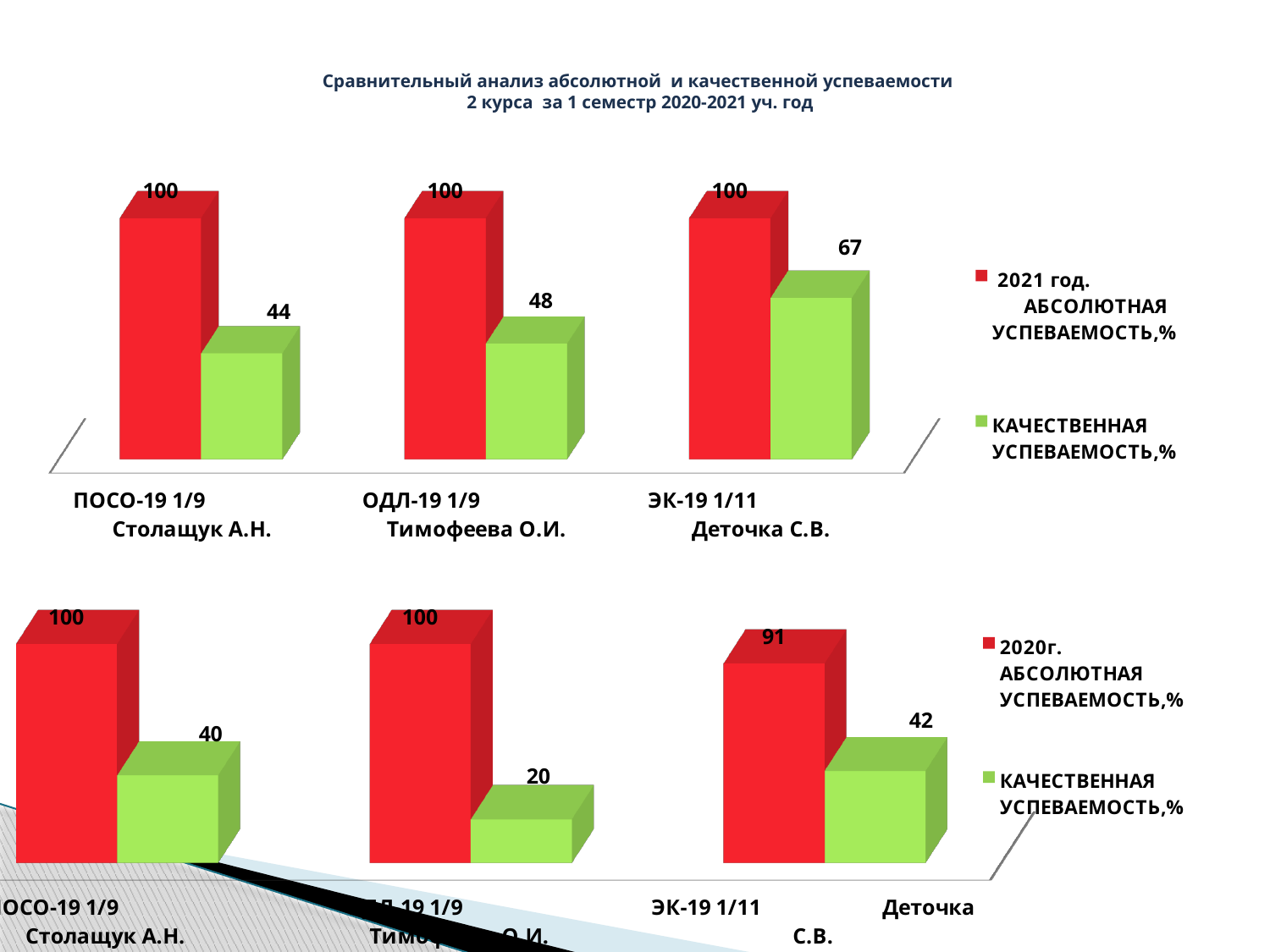
In the top chart (2021), which group has the highest КАЧЕСТВЕННАЯ УСПЕВАЕМОСТЬ? ЭК-19 1/11 Деточка С.В. In the top chart (2021), what is the value of КАЧЕСТВЕННАЯ УСПЕВАЕМОСТЬ for ЭК-19 1/11 Деточка С.В.? 67 In the top chart (2021), which is larger: КАЧЕСТВЕННАЯ УСПЕВАЕМОСТЬ for ПОСО-19 1/9 Столащук А.Н. or for ОДЛ-19 1/9 Тимофеева О.И.? ОДЛ-19 1/9 Тимофеева О.И. In the bottom chart (2020), what is the value of АБСОЛЮТНАЯ УСПЕВАЕМОСТЬ for ЭК-19 1/11 Деточка С.В.? 91 In the top chart (2021), what is the value of КАЧЕСТВЕННАЯ УСПЕВАЕМОСТЬ for ПОСО-19 1/9 Столащук А.Н.? 44 In the bottom chart (2020), what is the difference between КАЧЕСТВЕННАЯ УСПЕВАЕМОСТЬ for ЭК-19 1/11 Деточка С.В. and for ПОСО-19 1/9 Столащук А.Н.? 2 In the bottom chart (2020), what is the value of КАЧЕСТВЕННАЯ УСПЕВАЕМОСТЬ for Тимофеева О.И.? 20 In the bottom chart (2020), which group has the lowest КАЧЕСТВЕННАЯ УСПЕВАЕМОСТЬ? ОДЛ-19 1/9 Тимофеева О.И. What type of chart is the top chart (2021)? Bar chart How many series does the legend of the bottom chart (2020) list? 2 How many groups (categories) are shown in the top chart (2021)? 3 In the top chart (2021), what is the difference between АБСОЛЮТНАЯ and КАЧЕСТВЕННАЯ УСПЕВАЕМОСТЬ for ОДЛ-19 1/9 Тимофеева О.И.? 52